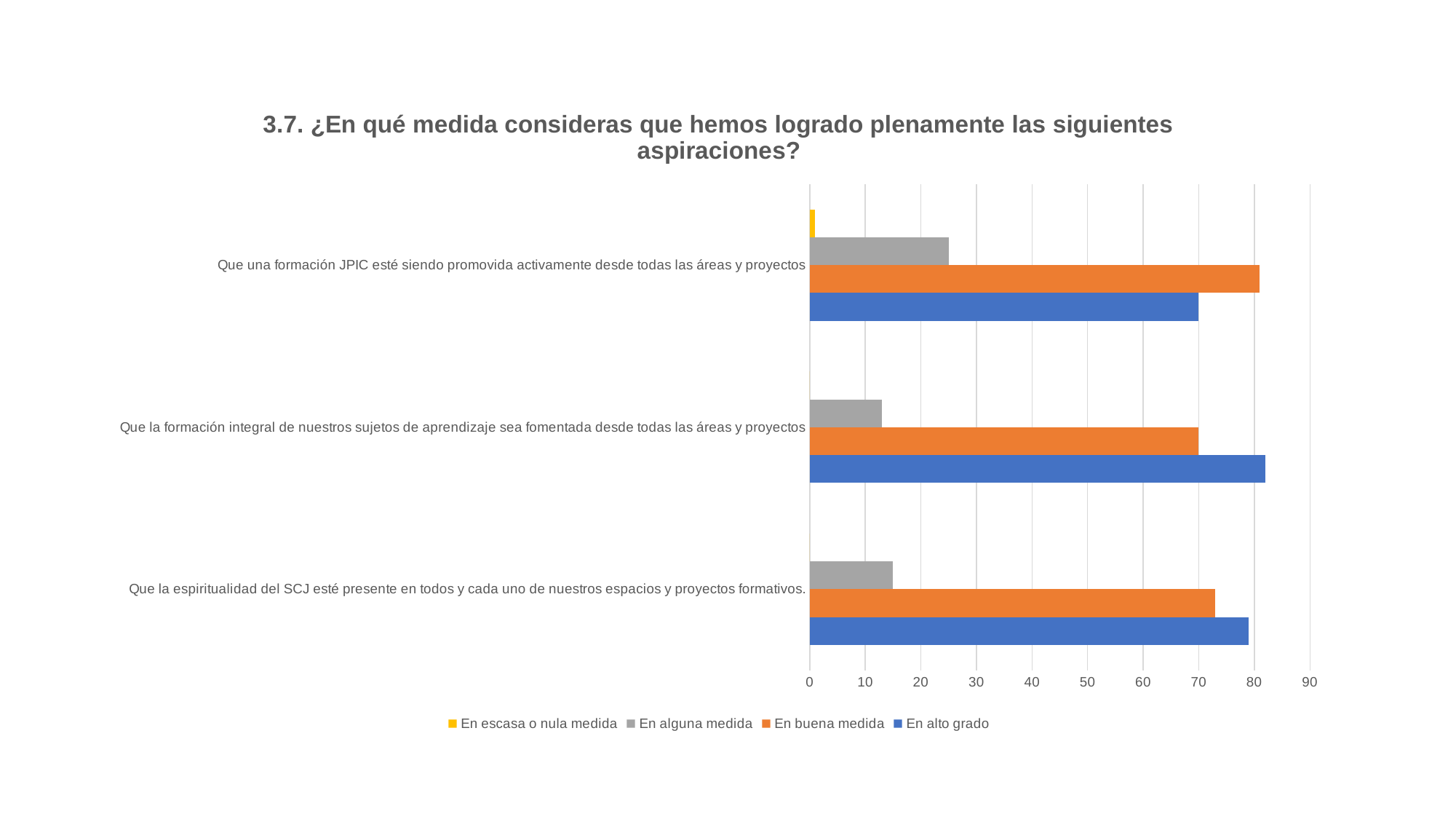
How many aspirations (categories) are plotted on the chart? 3 Is the value for "En alguna medida" for the aspiration "Que una formación JPIC esté siendo promovida activamente desde todas las áreas y proyectos" greater or less than 20? greater Which aspiration has the highest value for "En alguna medida"? Que una formación JPIC esté siendo promovida activamente desde todas las áreas y proyectos For the aspiration "Que la formación integral de nuestros sujetos de aprendizaje sea fomentada desde todas las áreas y proyectos", which is larger: "En alto grado" or "En buena medida"? En alto grado Is the value for "En alto grado" for the aspiration "Que la espiritualidad del SCJ esté presente en todos y cada uno de nuestros espacios y proyectos formativos" greater or less than 70? greater Is the value for "En alguna medida" for the aspiration "Que la formación integral de nuestros sujetos de aprendizaje sea fomentada desde todas las áreas y proyectos" greater or less than 20? less How many series does the legend list? 4 Which legend entry is shown in orange? En buena medida For the aspiration "Que una formación JPIC esté siendo promovida activamente desde todas las áreas y proyectos", which is larger: "En buena medida" or "En alto grado"? En buena medida What kind of chart is shown on the slide? bar chart